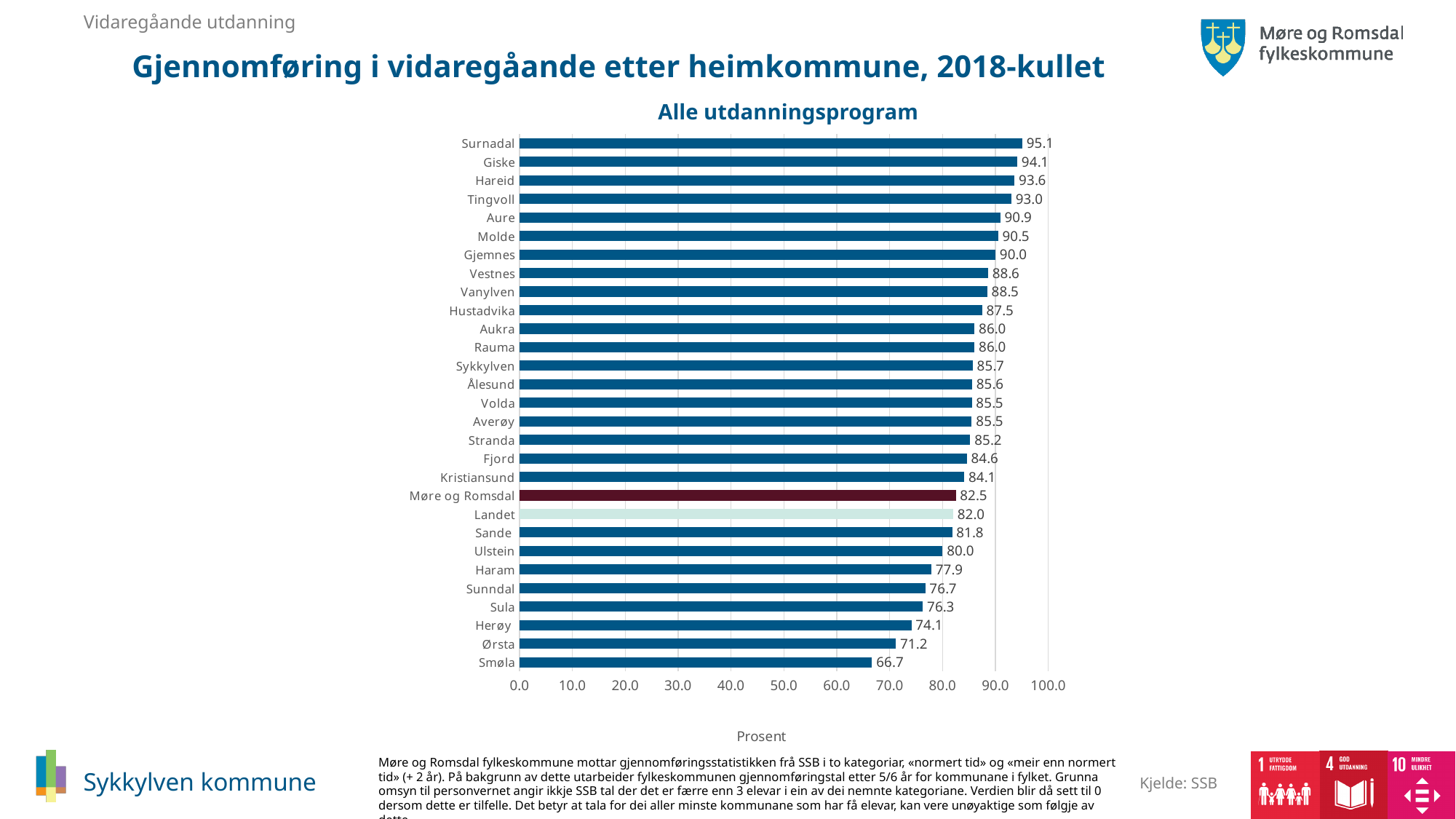
What is the value for Møre og Romsdal? 82.5 What is the difference between the values for Sykkylven and Møre og Romsdal? 3.2 Which is larger, the value for Molde or the value for Ålesund? Molde Is the value for Herøy greater or less than 80.0? less What kind of chart is shown on the slide? bar chart What is the value for Landet? 82.0 Which category has the lowest value? Smøla Which category has the highest value? Surnadal What is the difference between the values for Surnadal and Smøla? 28.4 How many categories are shown in the chart? 29 What is the value for Sykkylven? 85.7 What is the title of the chart? Alle utdanningsprogram